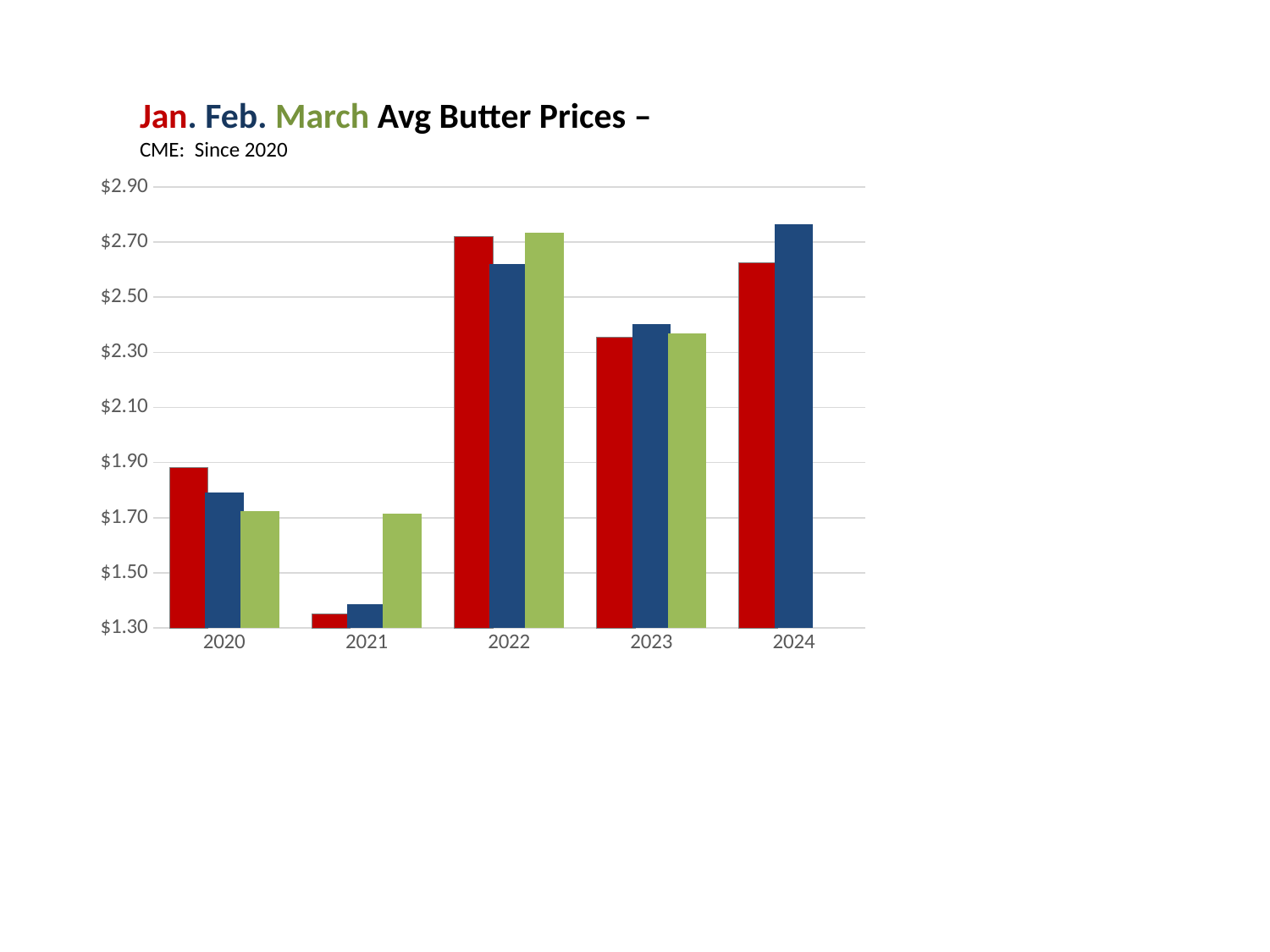
How many years are shown on the x axis? 5 How many series (months) does the chart plot, as indicated by the coloured words in the title? 3 Is the Jan. value for 2020 greater or less than $1.70? greater Is the Jan. value for 2021 greater or less than $1.50? less What is the subtitle text shown under the chart title? CME: Since 2020 In 2021, which month has the highest bar? March Which year has the lowest Jan. (red) bar? 2021 Is the Feb. value for 2022 greater or less than $2.70? less In 2020, which month has the highest bar? Jan. Which is larger, the Jan. value for 2022 or the Jan. value for 2023? 2022 What kind of chart is shown on the slide? bar chart